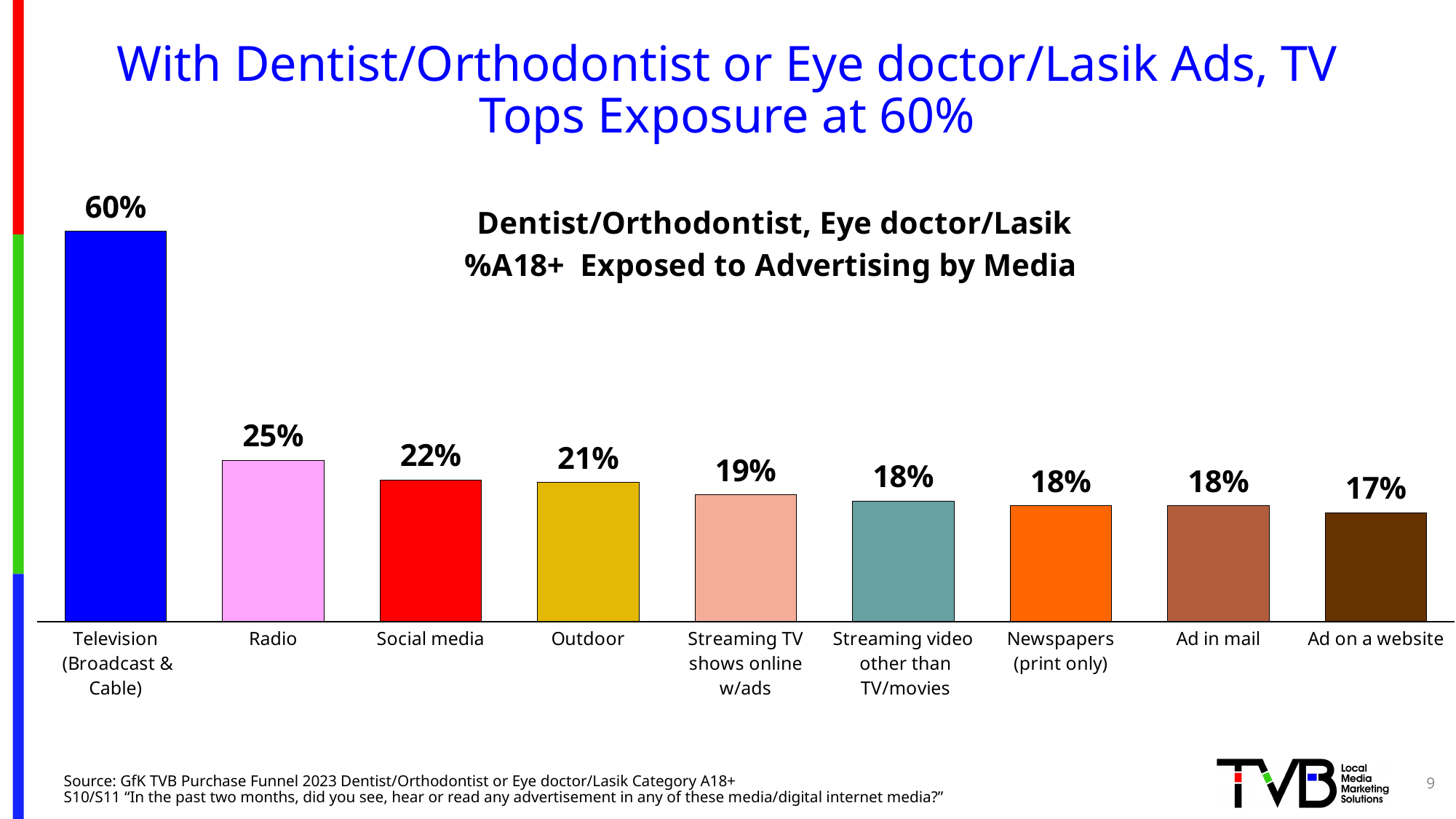
What percentage of A18+ were exposed to Dentist/Orthodontist or Eye doctor/Lasik advertising on Television (Broadcast & Cable)? 60% What is the value shown for Streaming TV shows online w/ads? 19% Which has a higher value, Radio or Social media? Radio What is the value shown for Ad on a website? 17% What is the difference in percentage points between Social media and Outdoor? 1 What is the difference in percentage points between Television (Broadcast & Cable) and Radio? 35 What is the value shown for Radio? 25% What type of chart is shown on the slide? Bar chart Which media category has the highest exposure percentage? Television (Broadcast & Cable) Which media category has the lowest exposure percentage? Ad on a website How many media categories are shown in the chart? 9 What is the title of the chart? Dentist/Orthodontist, Eye doctor/Lasik %A18+ Exposed to Advertising by Media